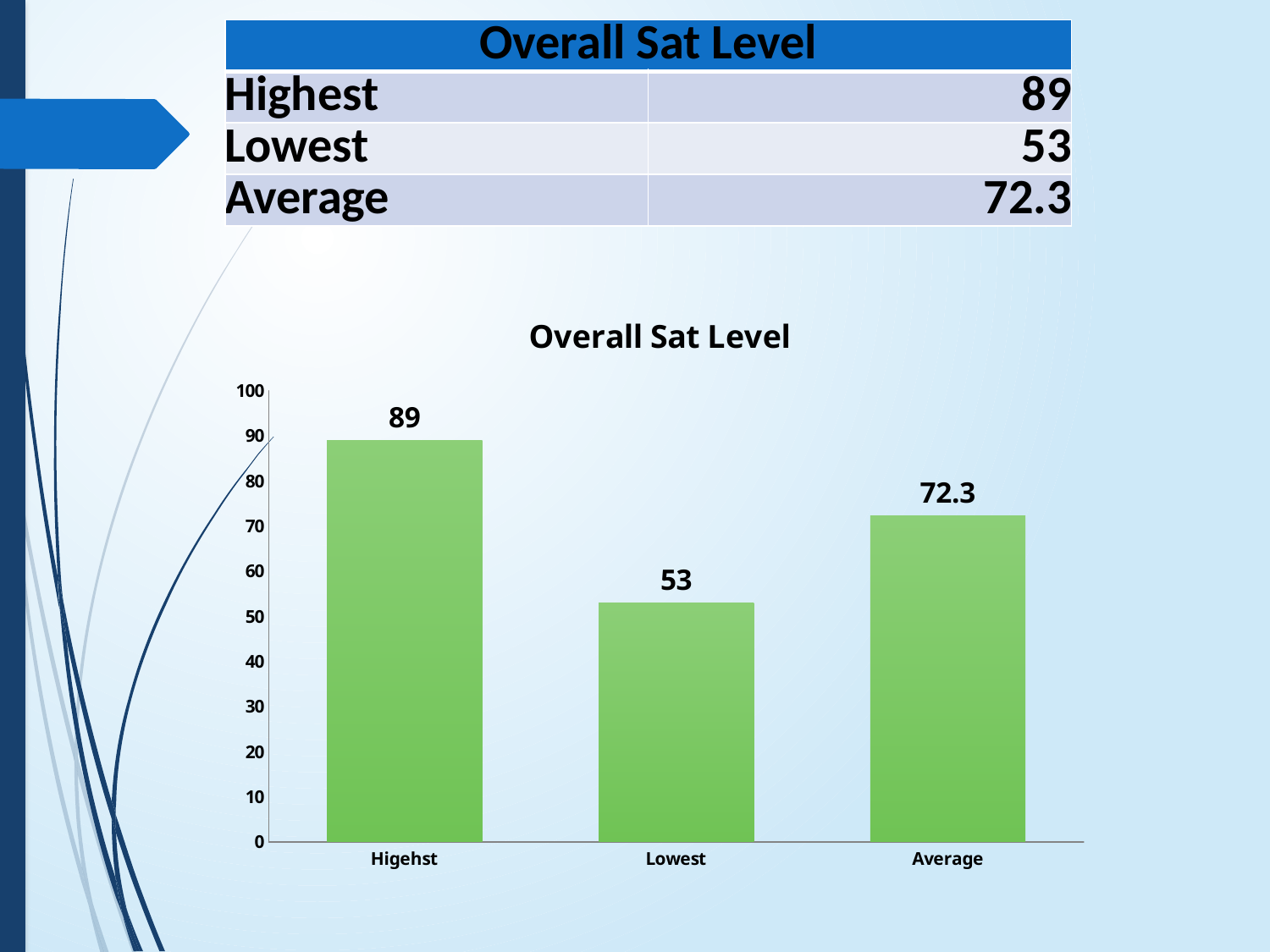
Which category has the lowest value in the Overall Sat Level chart? Lowest What is the value of the Lowest bar in the Overall Sat Level chart? 53 What is the value of the Higehst bar in the Overall Sat Level chart? 89 What is the value of the Average bar in the Overall Sat Level chart? 72.3 How many bars are shown in the Overall Sat Level chart? 3 What is the title of the chart on the slide? Overall Sat Level Which category has the highest value in the Overall Sat Level chart? Higehst What is the difference between the Higehst and Lowest bars in the Overall Sat Level chart? 36 What is the difference between the Average and Lowest bars in the Overall Sat Level chart? 19.3 What kind of chart is shown on the slide? bar chart Which is larger in the Overall Sat Level chart, the Average bar or the Lowest bar? Average Is the value for Average in the Overall Sat Level chart greater or less than 70? greater